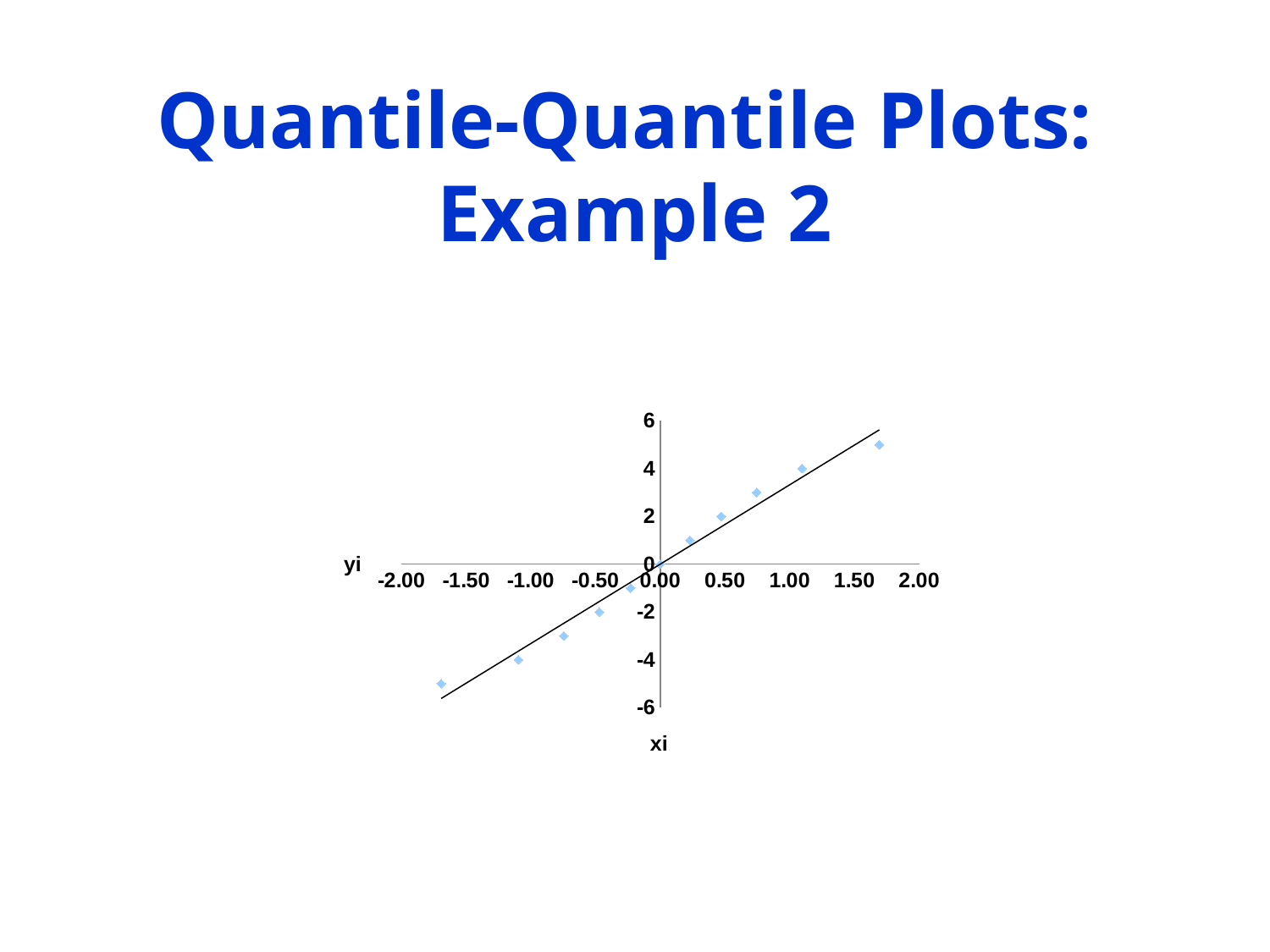
What is the label on the vertical axis of the chart? yi What is the maximum value shown on the vertical axis? 6 Is the yi value of the leftmost point greater or less than -4? less How many data points are plotted in the chart? 11 Is the yi value of the point nearest xi = 1.00 greater or less than 2? greater What is the minimum value shown on the horizontal axis? -2.00 Is the yi value of the point nearest xi = -1.00 greater or less than -2? less Which point has the highest yi value, the leftmost point or the rightmost point? the rightmost point What kind of chart is shown on the slide? scatter plot Do the plotted values rise or fall as xi increases along the x axis? rise What is the label on the horizontal axis of the chart? xi